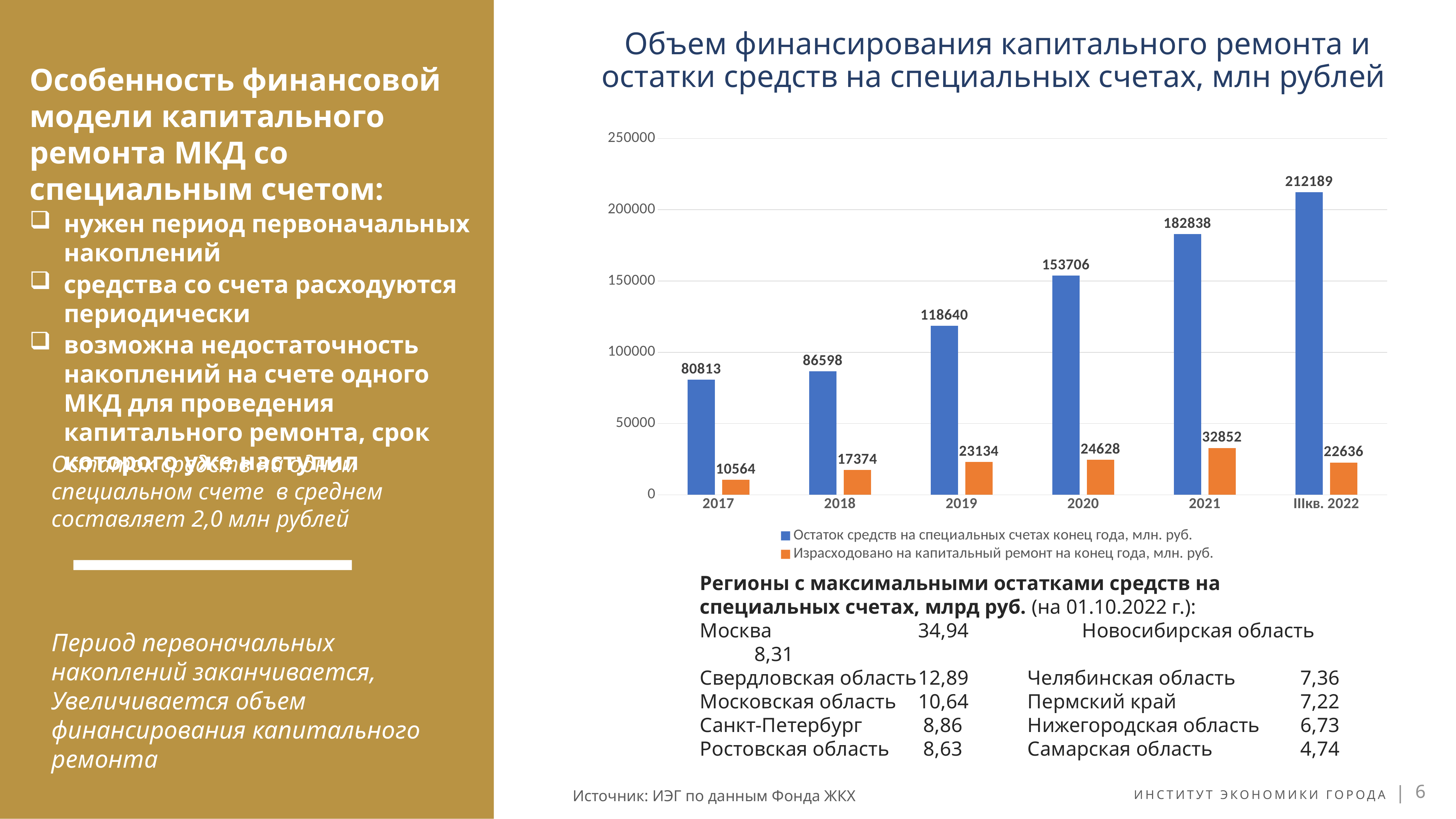
What kind of chart is shown on the slide? bar chart Is the value of 'Остаток средств на специальных счетах конец года' for 2018 greater or less than 100000? less What is the value of 'Остаток средств на специальных счетах конец года' for 2019? 118640 How many periods are shown on the x axis of the chart? 6 In which period is 'Остаток средств на специальных счетах конец года' lowest? 2017 Does 'Остаток средств на специальных счетах конец года' rise or fall from 2017 to IIIкв. 2022? rise What is the difference between 'Остаток средств на специальных счетах конец года' in 2021 and in 2020? 29132 What is the value of 'Остаток средств на специальных счетах конец года' for IIIкв. 2022? 212189 In which period is 'Израсходовано на капитальный ремонт на конец года' highest? 2021 Which is larger: 'Израсходовано на капитальный ремонт на конец года' in 2020 or in IIIкв. 2022? 2020 How many series does the chart legend list? 2 What is the value of 'Израсходовано на капитальный ремонт на конец года' for 2021? 32852